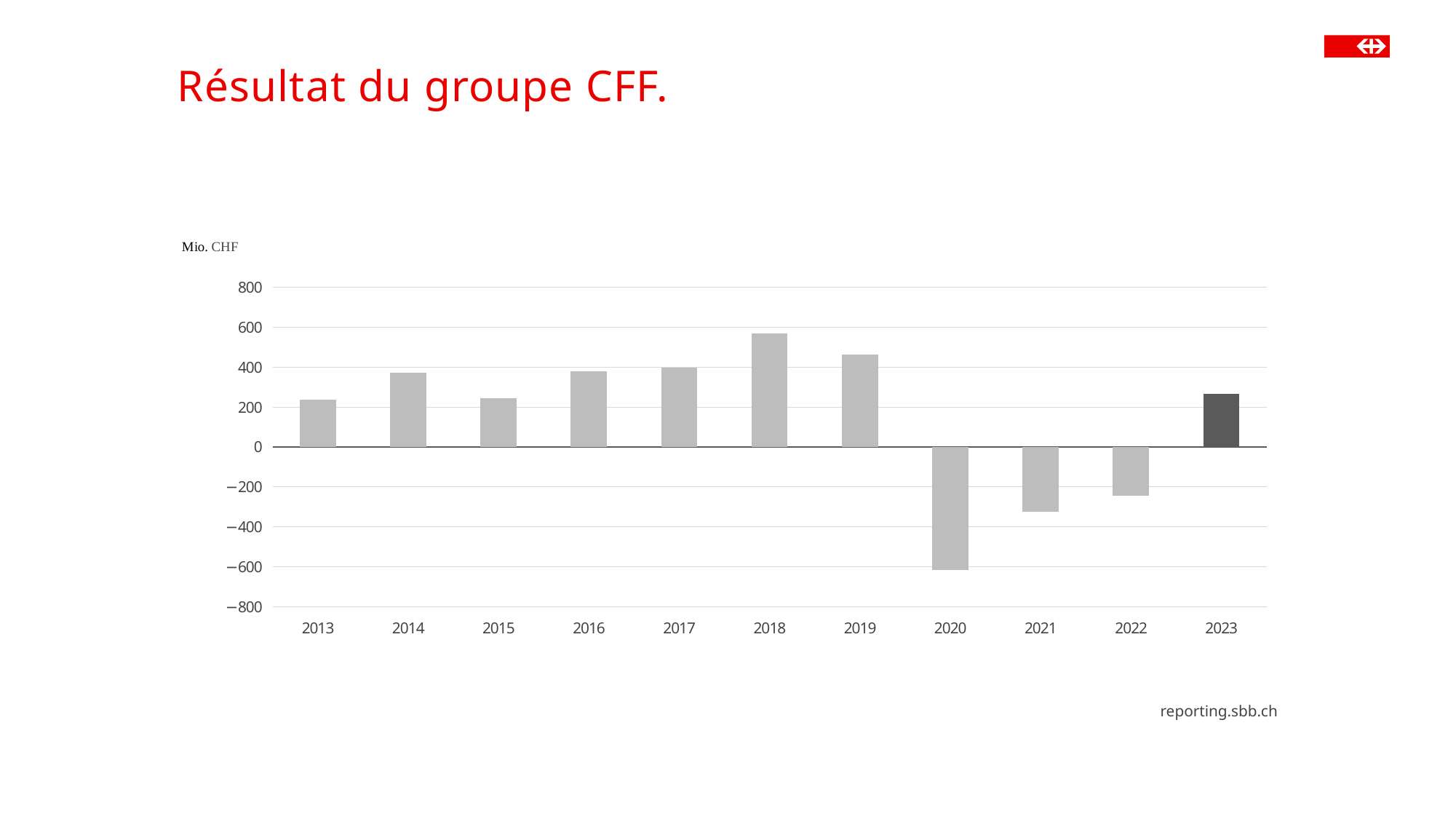
What is the title of the slide? Résultat du groupe CFF. Which year has the larger value, 2018 or 2019? 2018 Is the value for 2020 greater or less than −400? less Is the value for 2021 greater or less than −200? less Which year has the lowest value on the chart? 2020 Is the value for 2014 greater or less than 400? less Which year has the larger value, 2020 or 2021? 2021 What unit is indicated above the vertical axis of the chart? Mio. CHF Which year has the highest value on the chart? 2018 What kind of chart is shown on the slide? bar chart How many years are plotted on the chart? 11